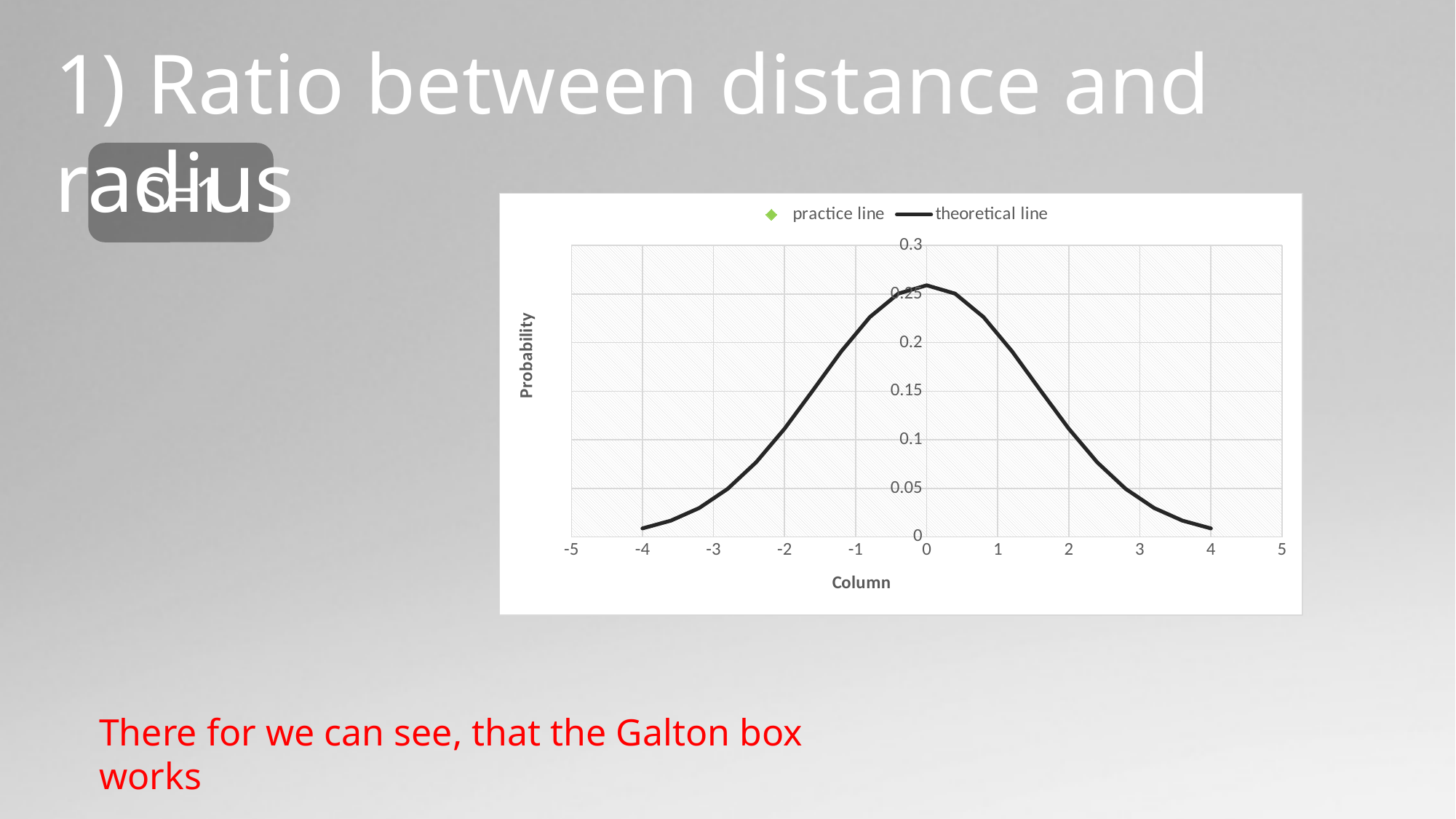
Does the theoretical line rise or fall as Column goes from 0 to 4? fall Is the value of the theoretical line at Column 0 greater or less than 0.2? greater How many series does the chart legend list? 2 At which Column value does the theoretical line reach its highest point? 0 What kind of chart is shown on the slide? line chart What is the title of the chart's vertical axis? Probability Does the theoretical line rise or fall as Column goes from -4 to 0? rise Is the value of the theoretical line at Column 3 greater or less than 0.05? less Which has the larger theoretical line value, Column 0 or Column 2? Column 0 What are the two series named in the chart legend? practice line and theoretical line